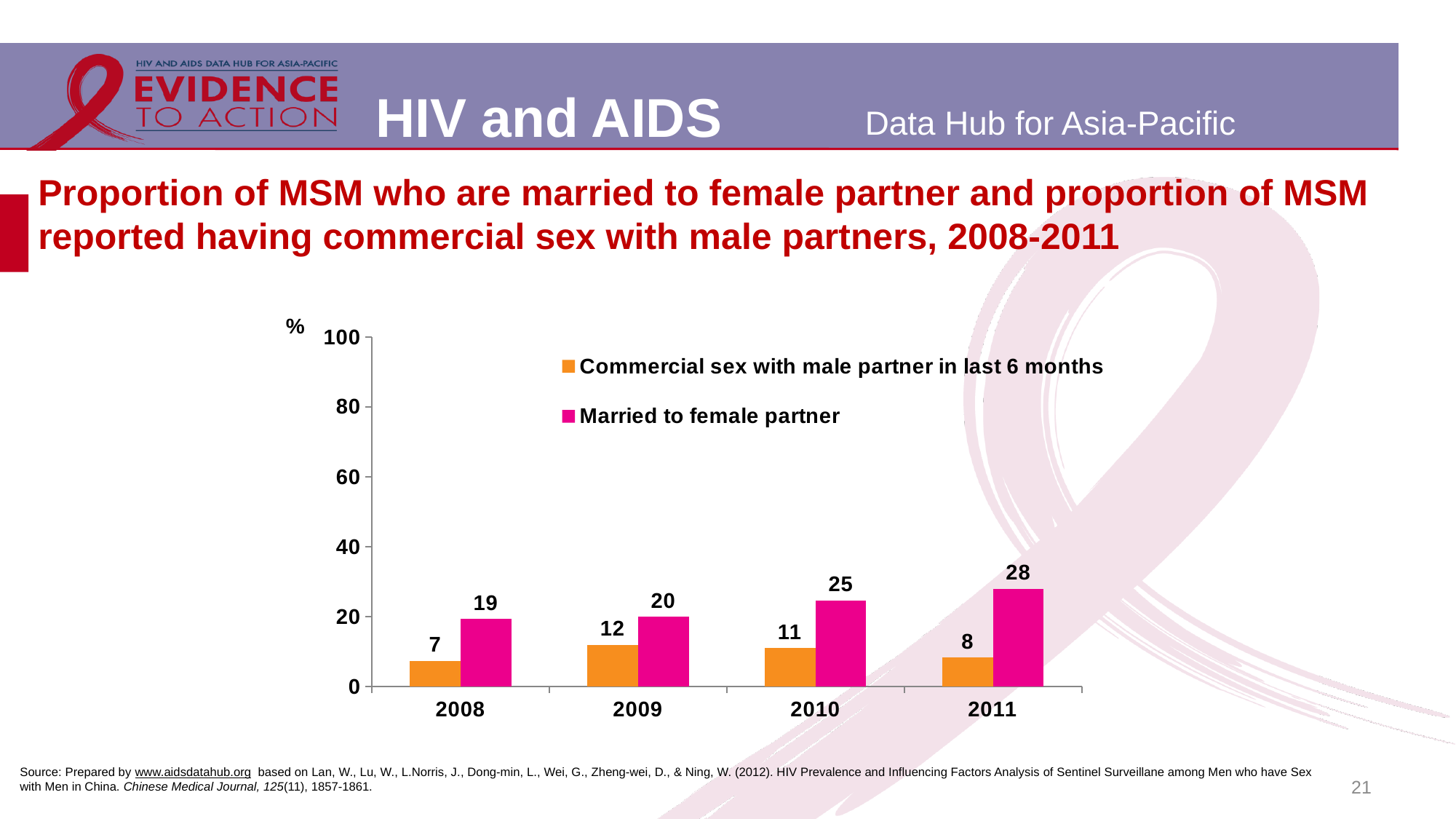
What is the value for 'Commercial sex with male partner in last 6 months' in 2008? 7 Is the value for 'Married to female partner' in 2011 greater or less than 20? greater Which is larger in 2009: 'Commercial sex with male partner in last 6 months' or 'Married to female partner'? Married to female partner What is the value for 'Married to female partner' in 2011? 28 In which year is the 'Married to female partner' value highest? 2011 What kind of chart is shown on the slide? Bar chart What is the difference between the 'Married to female partner' value and the 'Commercial sex with male partner in last 6 months' value in 2010? 14 Does the 'Married to female partner' value rise or fall from 2008 to 2011? Rise How many series does the legend list? 2 What is the value for 'Commercial sex with male partner in last 6 months' in 2009? 12 In which year is the 'Commercial sex with male partner in last 6 months' value lowest? 2008 How many years are shown on the x axis? 4